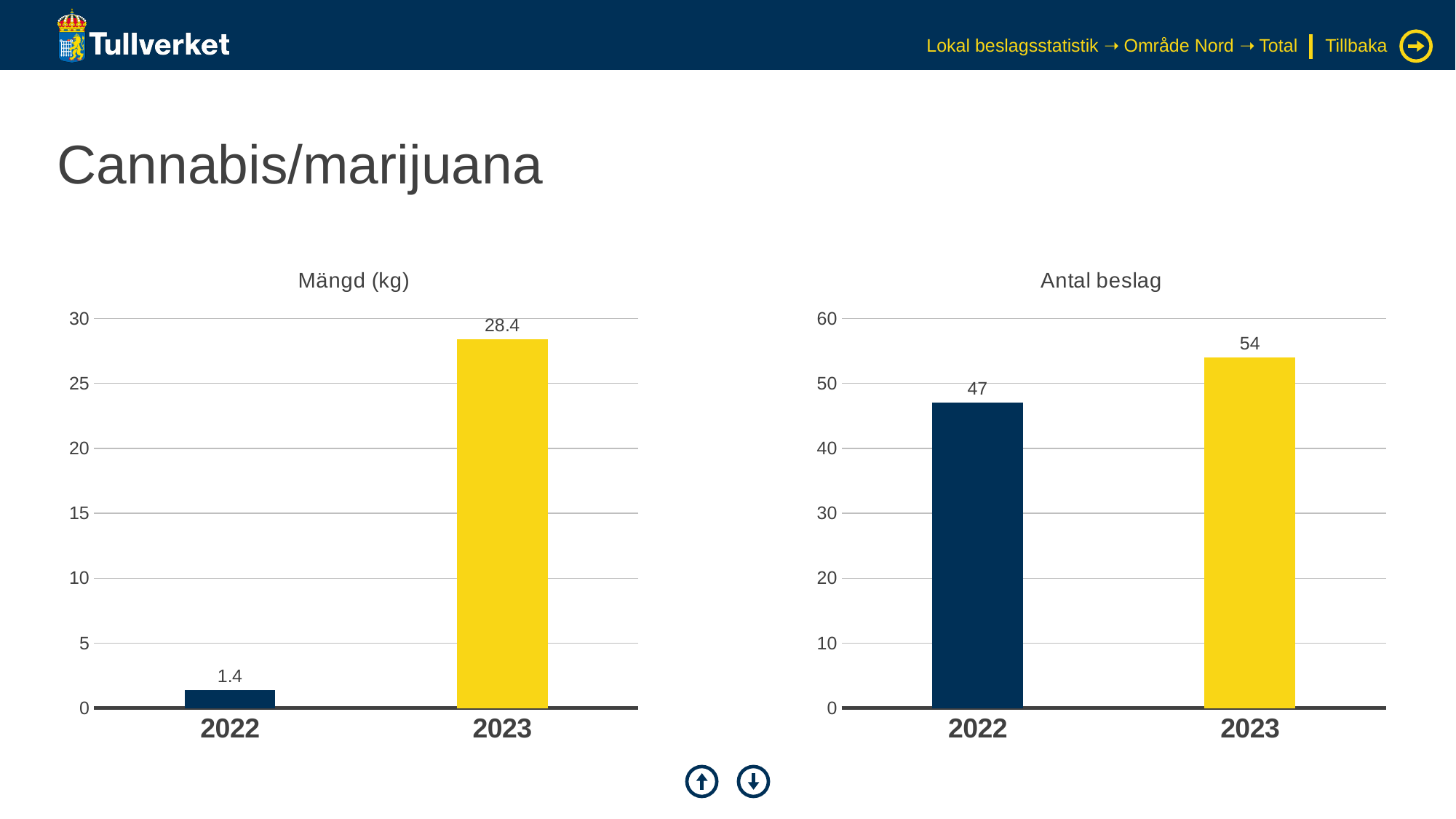
In the 'Antal beslag' chart, is the value for 2022 greater or less than 50? less What is the title of the chart on the left side of the slide? Mängd (kg) In the 'Mängd (kg)' chart, what is the value for 2023? 28.4 In the 'Mängd (kg)' chart, which year has the highest value? 2023 How many categories are shown on the x axis of the 'Mängd (kg)' chart? 2 In the 'Antal beslag' chart, what is the value for 2022? 47 In the 'Mängd (kg)' chart, what is the value for 2022? 1.4 In the 'Antal beslag' chart, what is the difference between the 2023 and 2022 values? 7 In the 'Antal beslag' chart, what is the value for 2023? 54 What kind of chart is the 'Antal beslag' chart? bar chart In the 'Antal beslag' chart, which year has the lowest value? 2022 In the 'Mängd (kg)' chart, what is the difference between the 2023 and 2022 values? 27